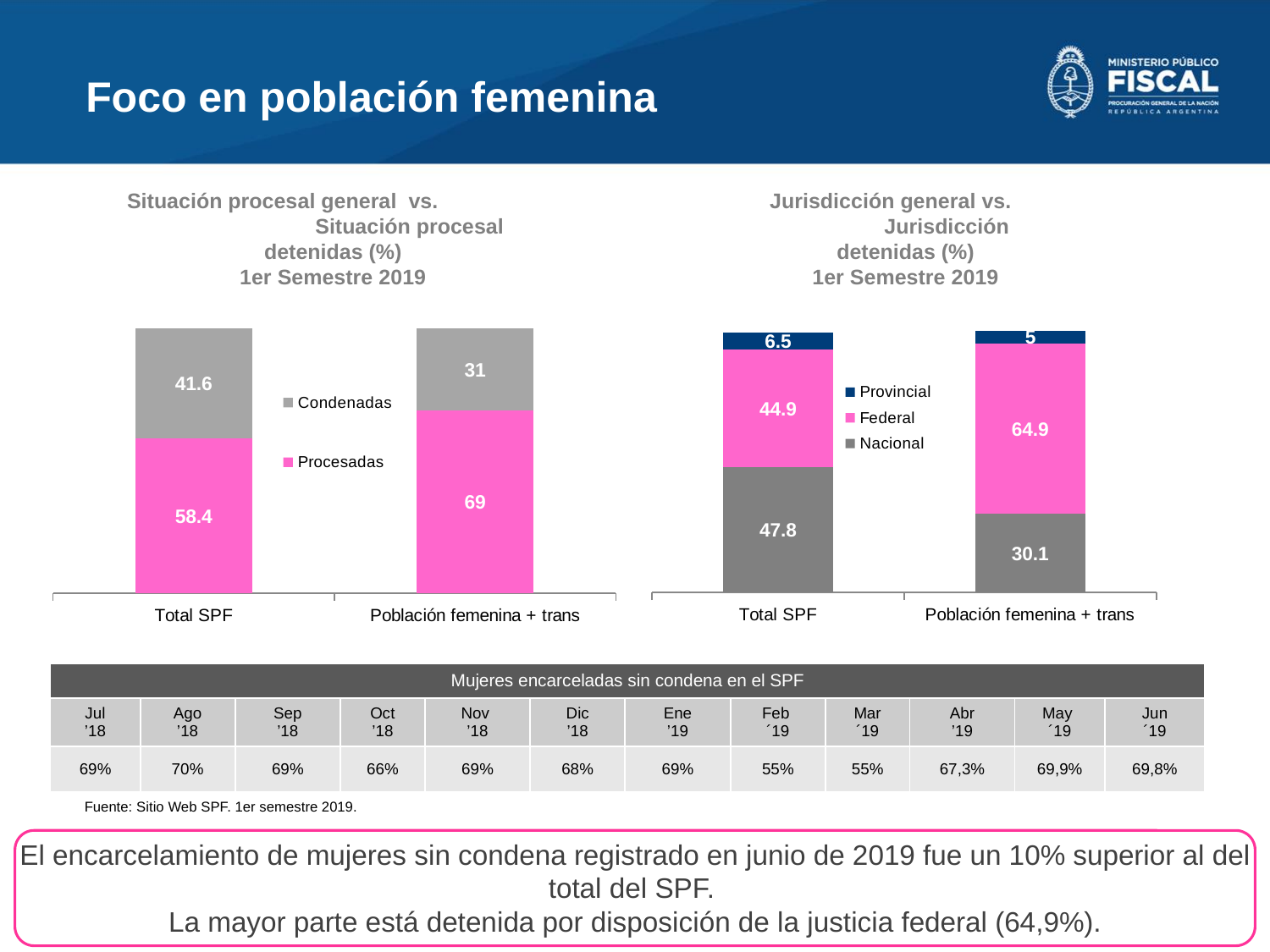
In the right chart (Jurisdicción), what is the Provincial value for Población femenina + trans? 5 In the left chart (Situación procesal), what is the Procesadas value for Total SPF? 58.4 In the left chart (Situación procesal), which category has the higher Condenadas value, Total SPF or Población femenina + trans? Total SPF In the right chart (Jurisdicción), what is the Federal value for Población femenina + trans? 64.9 In the right chart (Jurisdicción), what is the Nacional value for Total SPF? 47.8 In the left chart (Situación procesal), how many series does the legend list? 2 In the right chart (Jurisdicción), what is the total of the stacked bar for Total SPF? 99.2 In the left chart (Situación procesal), what is the difference between the Procesadas values for Población femenina + trans and Total SPF? 10.6 What kind of chart is the right chart (Jurisdicción)? Stacked bar chart In the right chart (Jurisdicción), how many series does the legend list? 3 In the left chart (Situación procesal), what is the Condenadas value for Población femenina + trans? 31 In the right chart (Jurisdicción), which series has the largest value for Población femenina + trans? Federal